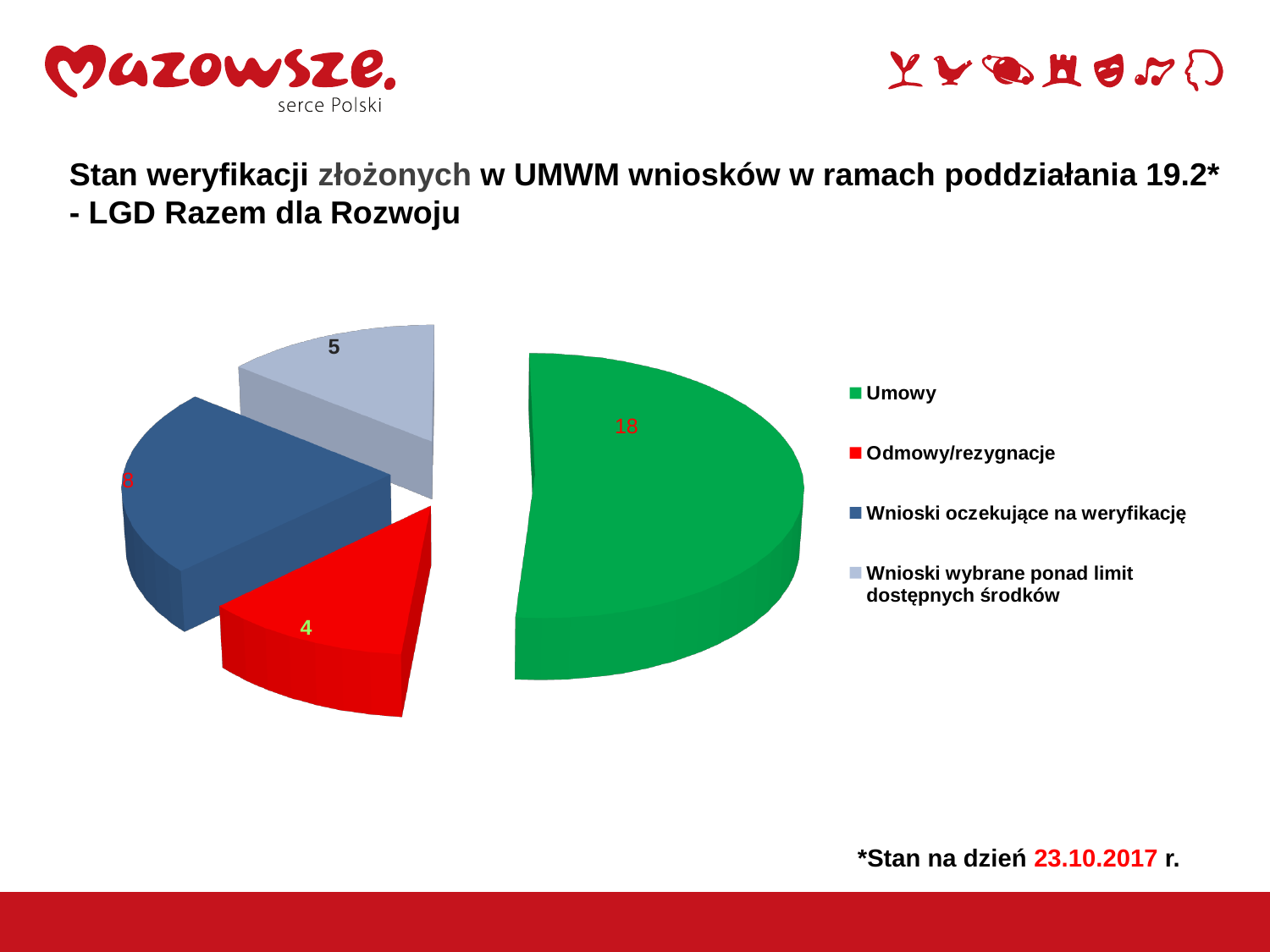
Which is larger: Umowy or Wnioski oczekujące na weryfikację? Umowy What colour is the slice for Umowy? green Which is larger: Odmowy/rezygnacje or Wnioski wybrane ponad limit dostępnych środków? Wnioski wybrane ponad limit dostępnych środków What is the difference between the values for Umowy and Wnioski wybrane ponad limit dostępnych środków? 13 What is the difference between the values for Umowy and Odmowy/rezygnacje? 14 What is the value for Umowy? 18 Which category has the largest slice of the pie? Umowy What kind of chart is shown on the slide? pie chart How many slices does the pie chart have? 4 What is the value for Odmowy/rezygnacje? 4 What is the value for Wnioski wybrane ponad limit dostępnych środków? 5 Which category has the smallest slice of the pie? Odmowy/rezygnacje